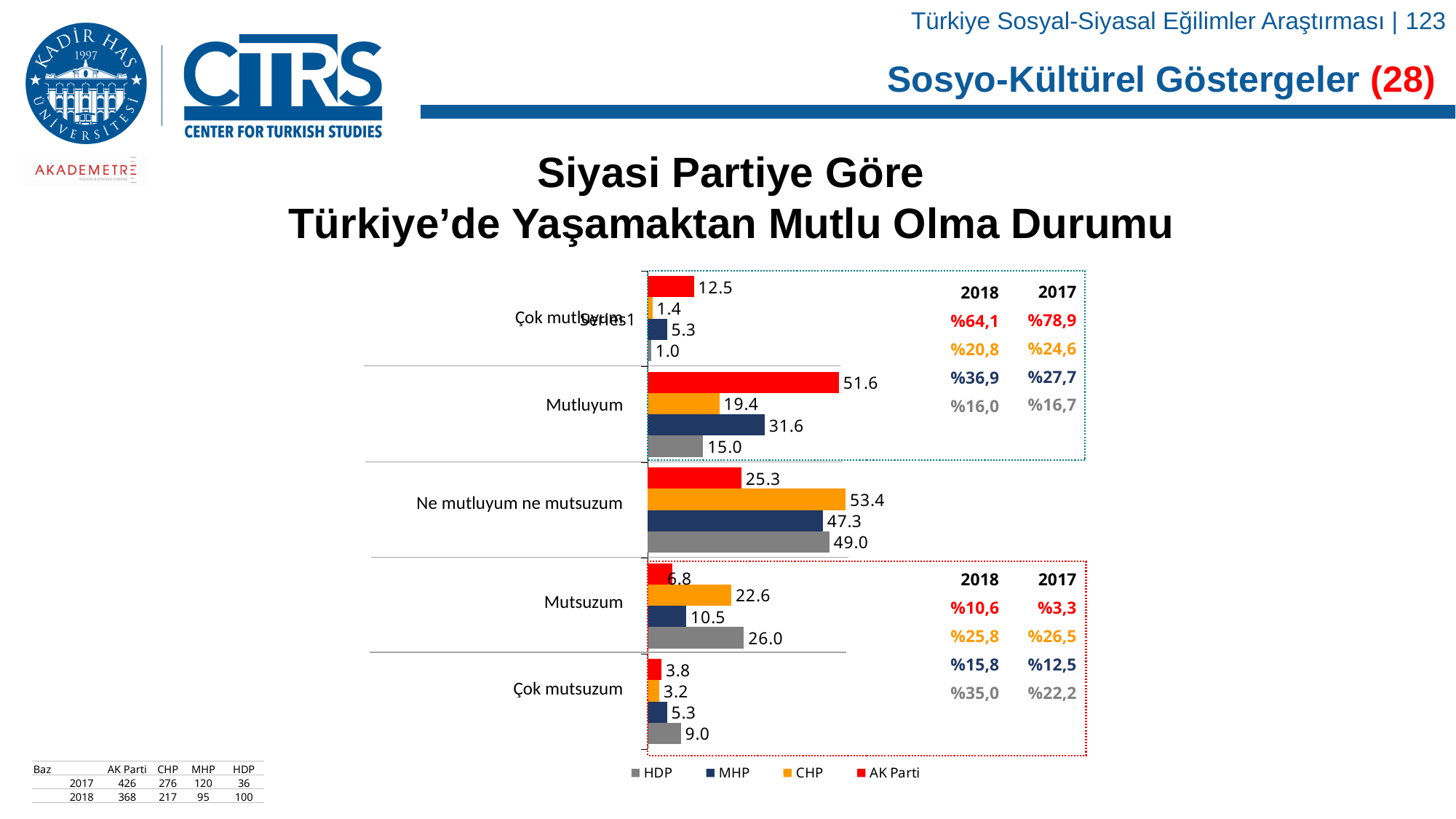
What is the value for CHP in the 'Mutsuzum' category? 22.6 In the 'Mutsuzum' category, which is larger: the value for HDP or the value for MHP? HDP How many series does the legend list? 4 What is the value for AK Parti in the 'Mutluyum' category? 51.6 Which colour represents AK Parti in the chart? Red Which party has the lowest value in the 'Mutluyum' category? HDP What is the value for MHP in the 'Çok mutsuzum' category? 5.3 How many response categories are shown on the chart? 5 Which party has the highest value in the 'Ne mutluyum ne mutsuzum' category? CHP What type of chart is shown on the slide? Bar chart What is the value for HDP in the 'Ne mutluyum ne mutsuzum' category? 49.0 What is the difference between the AK Parti and CHP values in the 'Mutluyum' category? 32.2